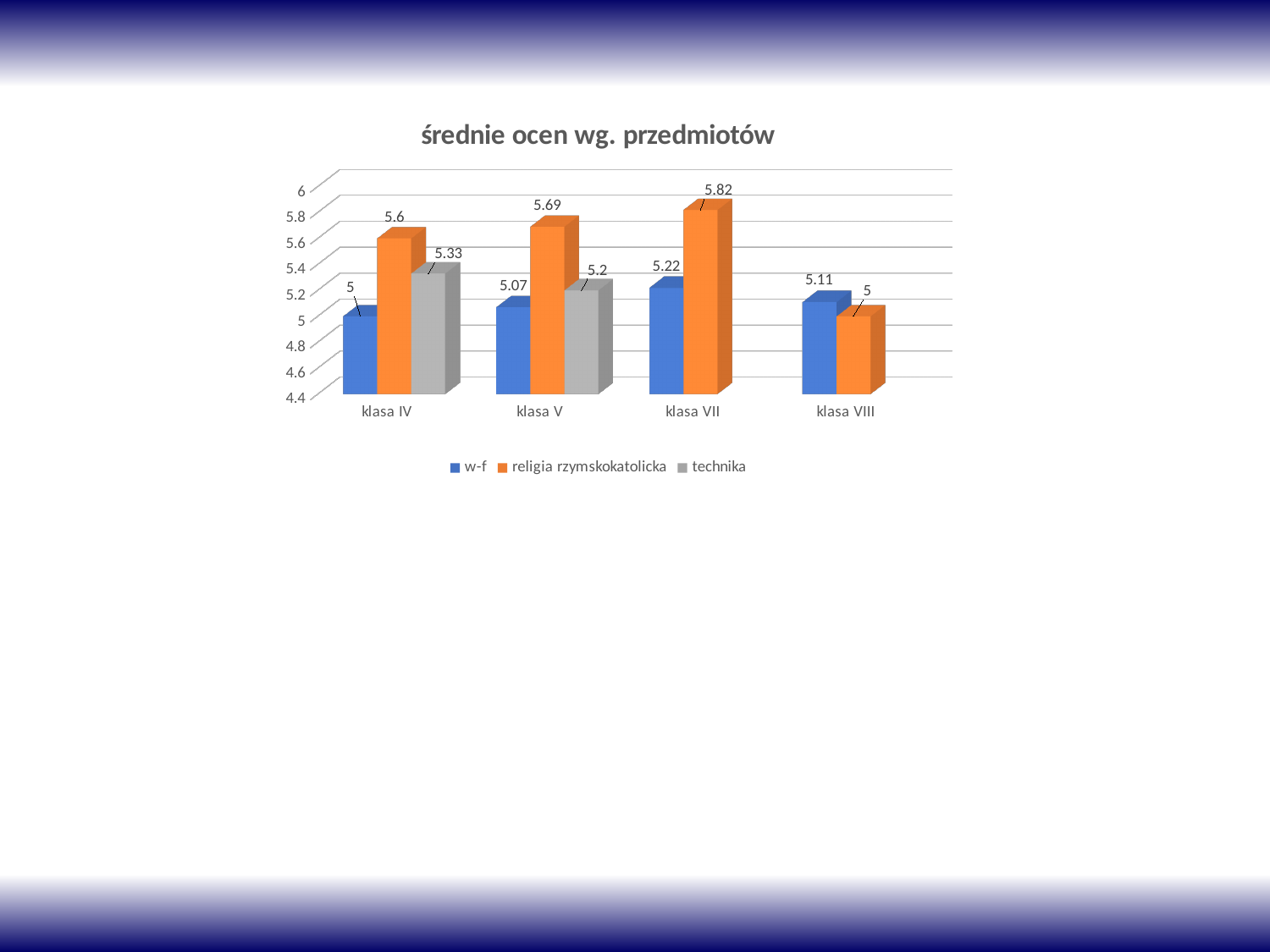
What is the title of the chart? średnie ocen wg. przedmiotów Which class has the highest value for religia rzymskokatolicka? klasa VII How many classes are shown on the x axis? 4 Which class has the lowest value for w-f? klasa IV What kind of chart is this? bar chart What is the value for religia rzymskokatolicka in klasa VII? 5.82 How many series does the legend list? 3 What is the value for religia rzymskokatolicka in klasa VIII? 5 What is the value for technika in klasa IV? 5.33 What is the difference between religia rzymskokatolicka and w-f in klasa IV? 0.6 What is the value for w-f in klasa V? 5.07 Which is larger in klasa V: religia rzymskokatolicka or technika? religia rzymskokatolicka